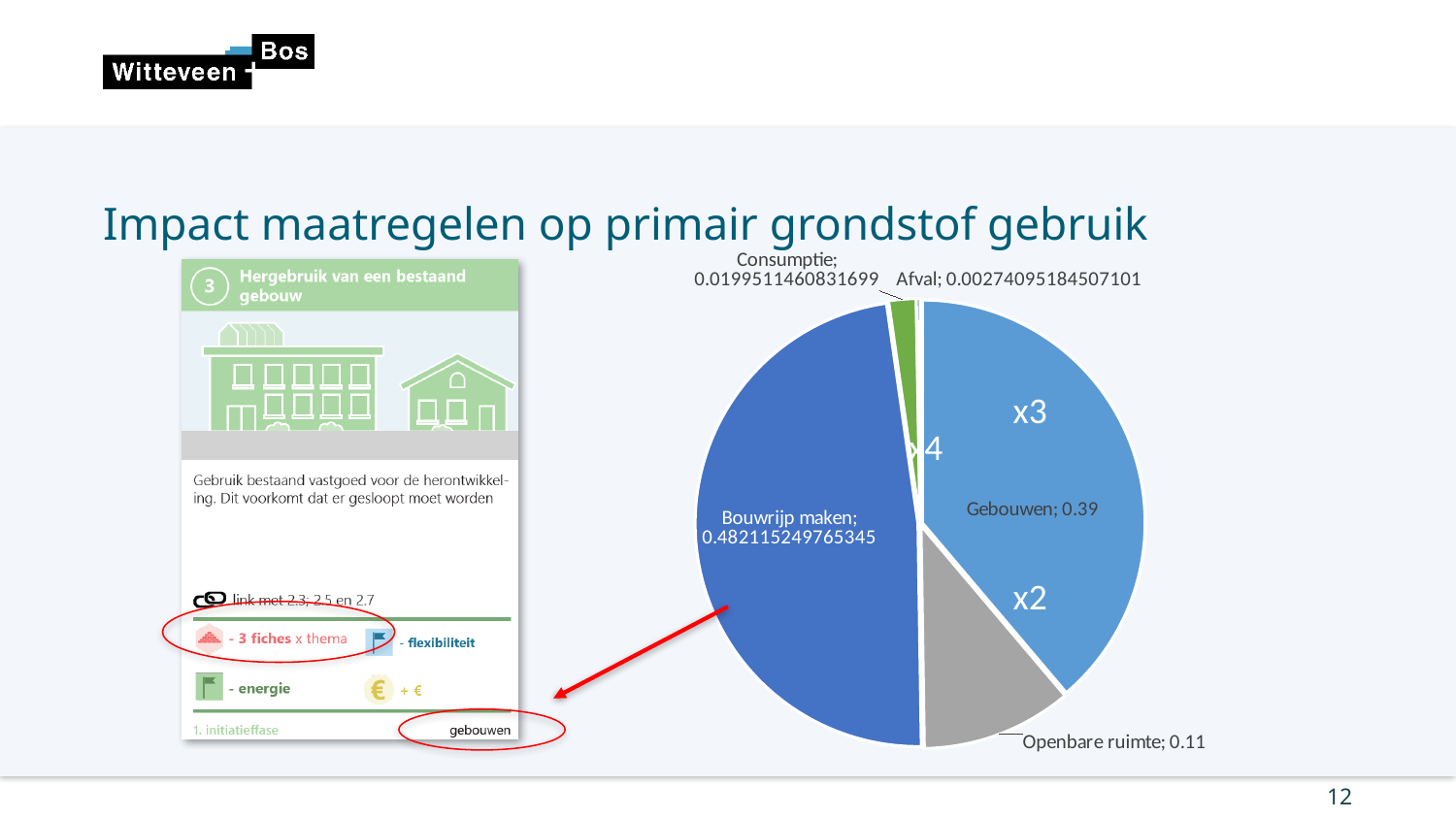
Which category has the largest slice in the pie chart? Bouwrijp maken Which category has the smallest slice in the pie chart? Afval What is the value for Afval in the pie chart? 0.00274095184507101 What is the difference between the values for Gebouwen and Openbare ruimte? 0.28 What is the value for Bouwrijp maken in the pie chart? 0.482115249765345 What is the value for Gebouwen in the pie chart? 0.39 Which is larger in the pie chart, Gebouwen or Openbare ruimte? Gebouwen How many slices does the pie chart have? 5 What is the value for Consumptie in the pie chart? 0.0199511460831699 What type of chart is shown on the slide? pie chart What is the value for Openbare ruimte in the pie chart? 0.11